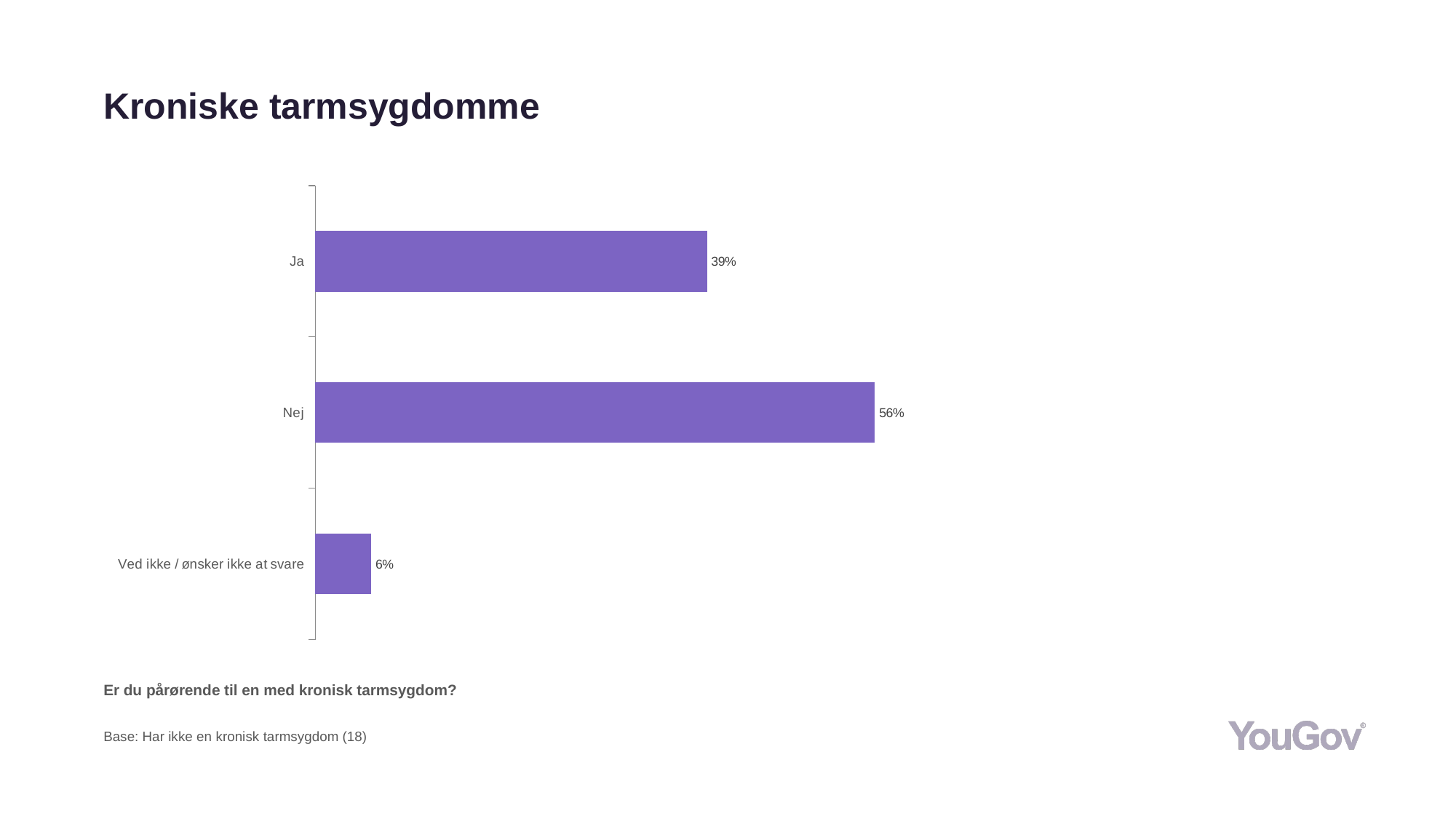
What is the value for "Ved ikke / ønsker ikke at svare"? 6% What is the difference between the values for "Nej" and "Ja"? 17% Which category has the lowest value? Ved ikke / ønsker ikke at svare What colour are the bars in the chart? Purple What kind of chart is shown on the slide? Bar chart Which is larger, the value for "Ja" or the value for "Nej"? Nej How many categories are shown in the chart? 3 What is the value for "Ja"? 39% What is the title of the slide? Kroniske tarmsygdomme What is the difference between the values for "Ja" and "Ved ikke / ønsker ikke at svare"? 33% Which category has the highest value? Nej What is the value for "Nej"? 56%